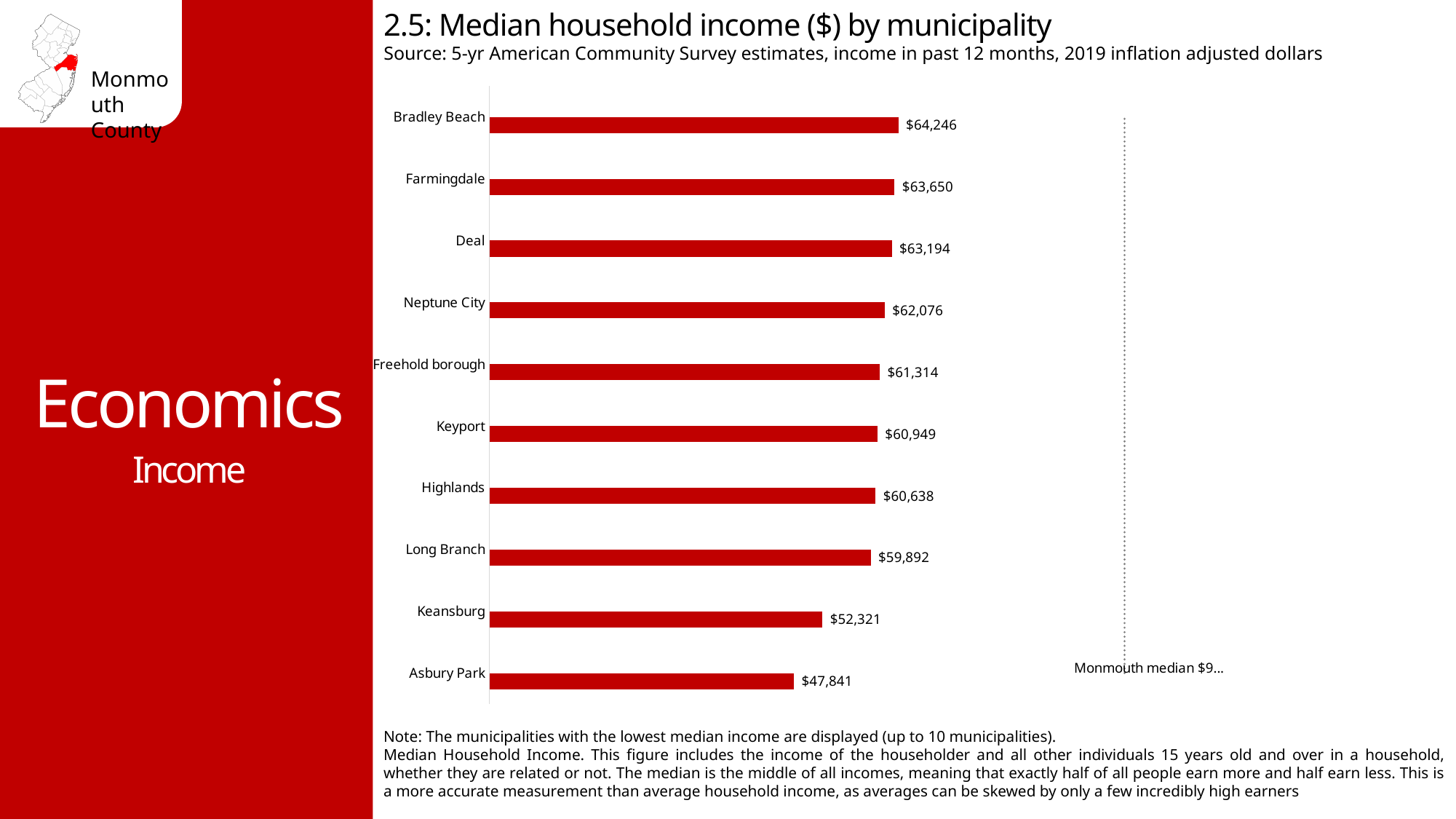
Which has a higher median household income, Neptune City or Highlands? Neptune City What is the median household income for Keansburg? $52,321 What is the median household income for Long Branch? $59,892 What is the title of the chart? 2.5: Median household income ($) by municipality How many municipalities are shown on the chart? 10 What is the median household income for Bradley Beach? $64,246 Which municipality has the lowest median household income shown on the chart? Asbury Park What is the difference between the median household income of Bradley Beach and Asbury Park? $16,405 What is the difference between the median household income of Keansburg and Asbury Park? $4,480 Which municipality has the highest median household income shown on the chart? Bradley Beach What kind of chart is used to show median household income by municipality? Bar chart Which has a higher median household income, Keansburg or Long Branch? Long Branch